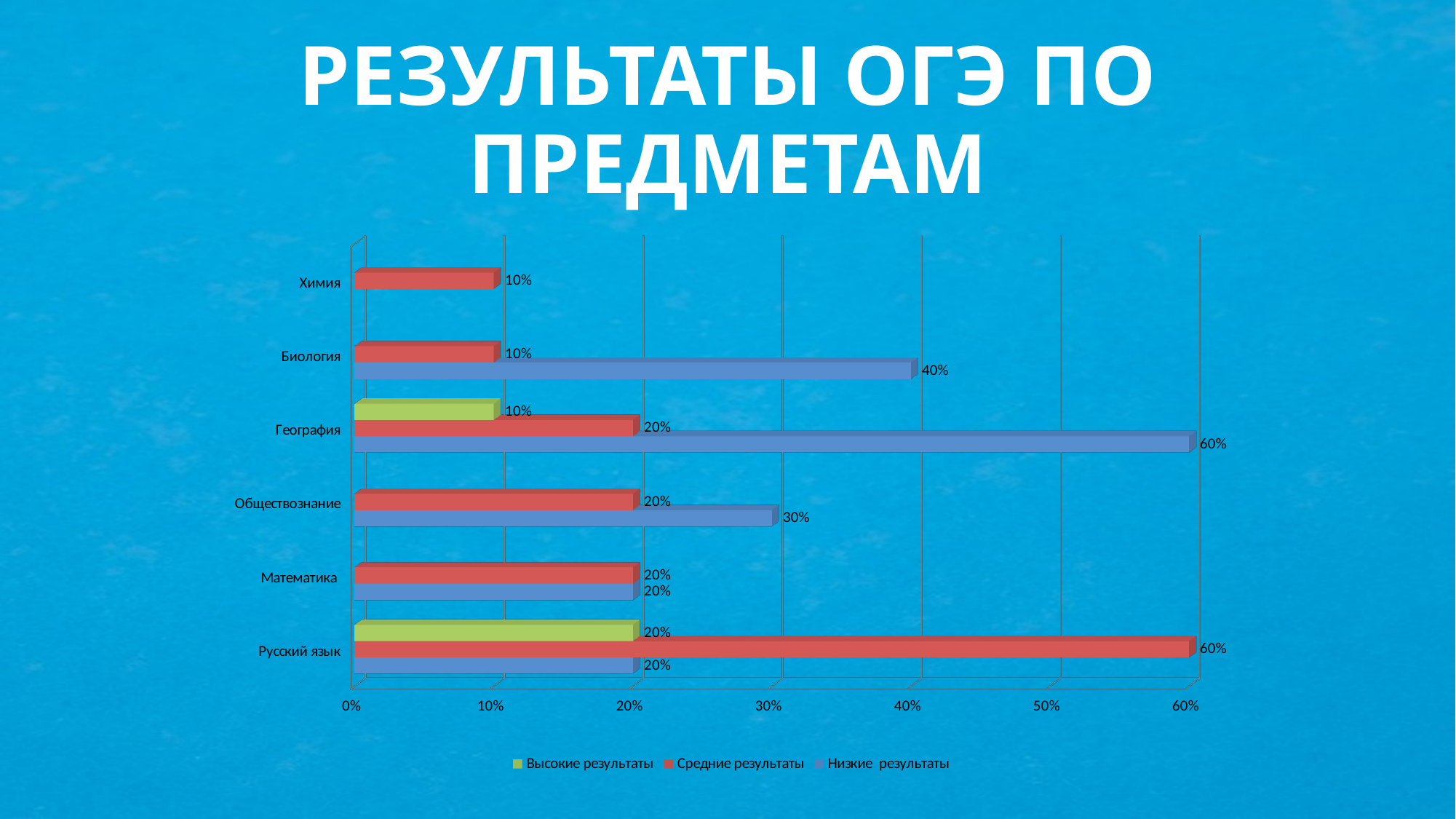
Which is larger: Низкие результаты for Биология or Низкие результаты for Математика? Биология What is the value of Высокие результаты for География? 10% What type of chart is shown on the slide? Bar chart Which subject has the highest value for Средние результаты? Русский язык What is the value of Низкие результаты for Биология? 40% How many subjects (categories) are shown on the chart? 6 What is the difference between Низкие результаты for География and for Обществознание? 30% Which subject has the highest value for Низкие результаты? География What is the value of Низкие результаты for География? 60% What is the value of Средние результаты for Русский язык? 60% Which series is shown in green in the legend? Высокие результаты How many series does the legend list? 3